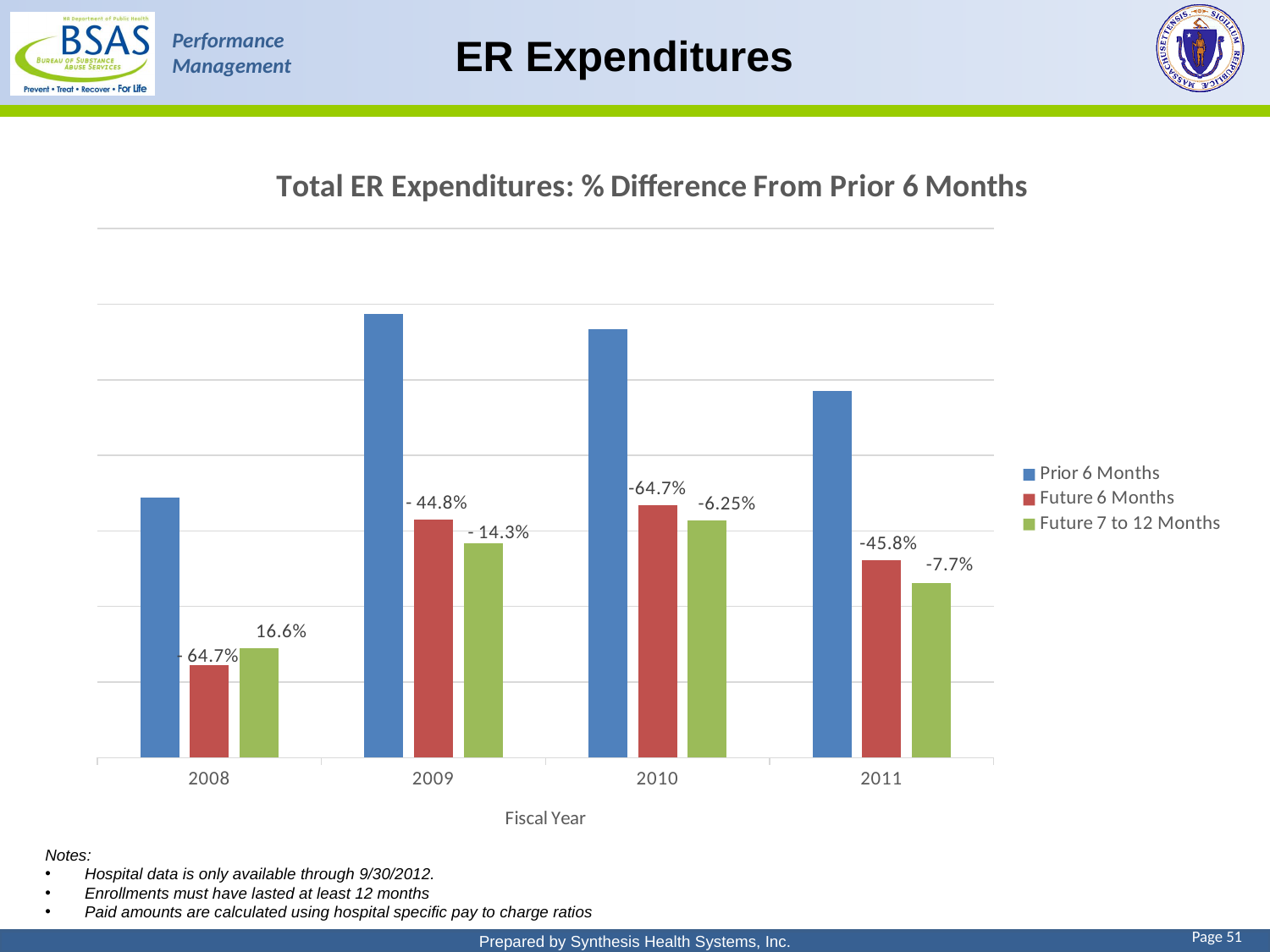
In which fiscal year is the Prior 6 Months bar the shortest? 2008 What is the data label for Future 7 to 12 Months in fiscal year 2010? -6.25% In which fiscal year is the Prior 6 Months bar the tallest? 2009 How many series does the legend list? 3 How many fiscal years are shown on the x axis? 4 What is the data label for Future 7 to 12 Months in fiscal year 2009? - 14.3% What is the data label for Future 7 to 12 Months in fiscal year 2011? -7.7% What is the data label for Future 6 Months in fiscal year 2011? -45.8% What is the data label for Future 6 Months in fiscal year 2009? - 44.8% What is the data label for Future 7 to 12 Months in fiscal year 2008? 16.6% What kind of chart is shown on the slide? Bar chart In fiscal year 2008, which bar is taller: Future 6 Months or Future 7 to 12 Months? Future 7 to 12 Months